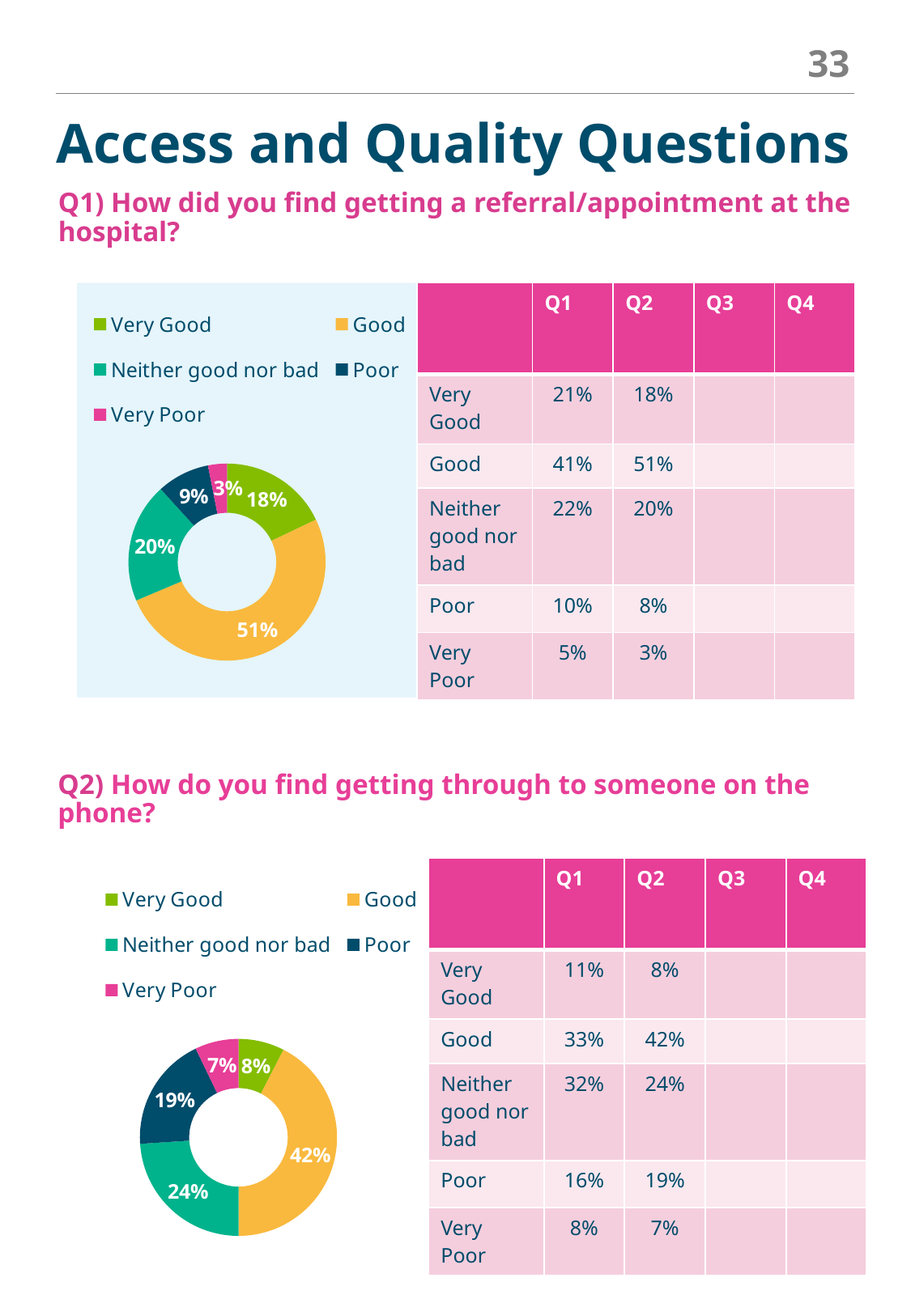
In the top chart (Q1, getting a referral/appointment at the hospital), what percentage is shown for Good? 51% In the bottom chart (Q2, getting through to someone on the phone), what percentage is shown for Poor? 19% In the bottom chart (Q2, getting through to someone on the phone), which is larger, Neither good nor bad or Poor? Neither good nor bad In the bottom chart (Q2, getting through to someone on the phone), what percentage is shown for Very Good? 8% In the top chart (Q1, getting a referral/appointment at the hospital), what is the difference between the Very Good and Poor slices? 9% In the bottom chart (Q2, getting through to someone on the phone), what is the difference between the Good and Neither good nor bad slices? 18% In the top chart (Q1, getting a referral/appointment at the hospital), what colour represents Very Poor? Pink What kind of chart is used for Q1 (getting a referral/appointment at the hospital)? Doughnut (pie) chart In the top chart (Q1, getting a referral/appointment at the hospital), what percentage is shown for Neither good nor bad? 20% In the top chart (Q1, getting a referral/appointment at the hospital), how many categories does the legend list? 5 In the bottom chart (Q2, getting through to someone on the phone), which category has the largest slice? Good In the top chart (Q1, getting a referral/appointment at the hospital), which category has the smallest slice? Very Poor